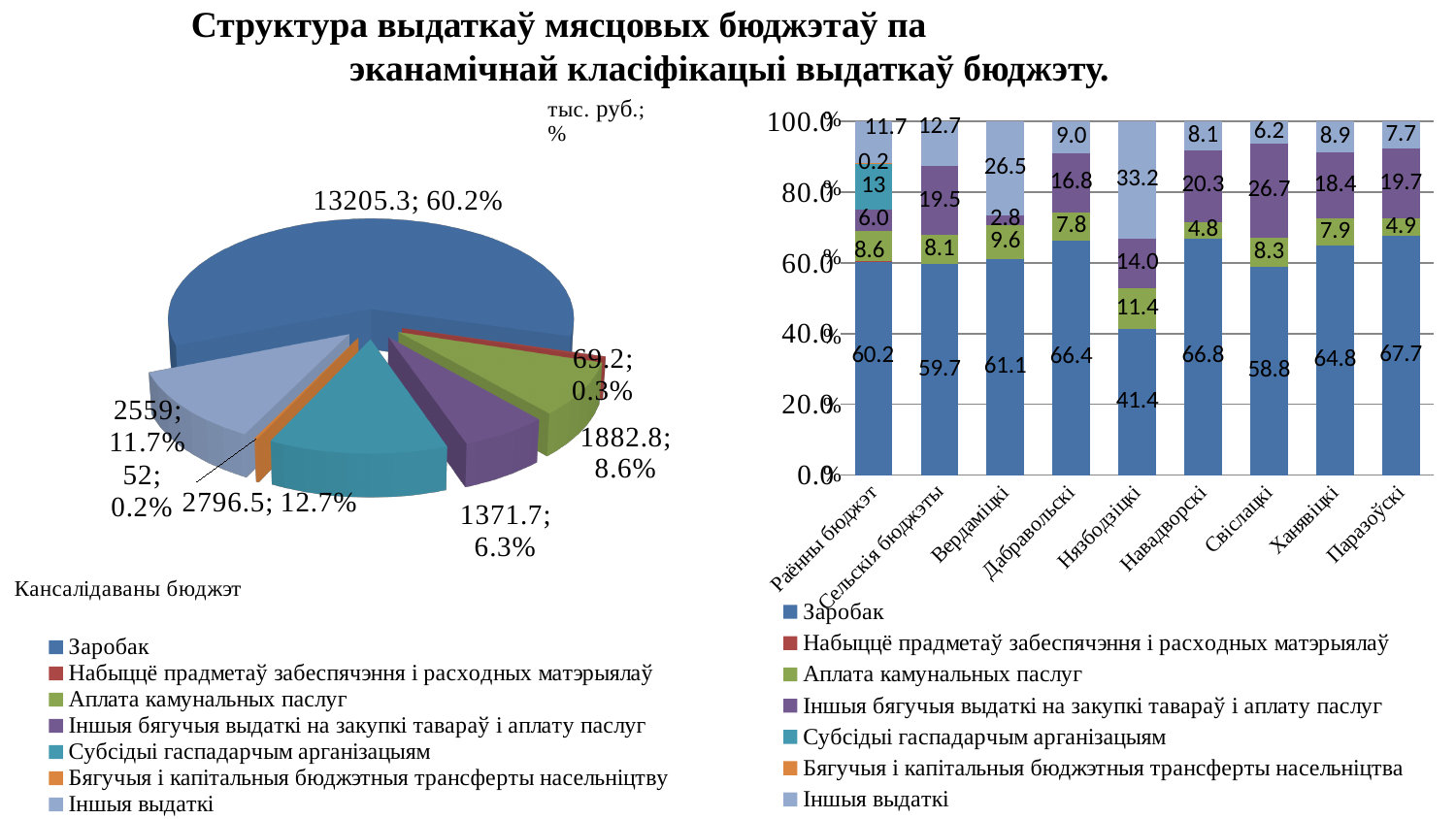
In the left pie chart, what value and share are shown for Заробак? 13205.3; 60.2% What type of chart is the right chart? stacked bar chart In the right bar chart, what is the Заробак value for Нязбодзіцкі? 41.4 What type of chart is the left chart (Кансалідаваны бюджэт)? pie chart In the left pie chart, what share does Субсідыі гаспадарчым арганізацыям have? 12.7% In the left pie chart, which category has the smallest slice? Бягучыя і капітальныя бюджэтныя трансферты насельніцтву In the right bar chart, which category has the highest Заробак value? Паразоўскі In the right bar chart, which category has the lowest Заробак value? Нязбодзіцкі In the right bar chart, how many series does the legend list? 7 In the left pie chart, how many categories does the legend list? 7 In the right bar chart, what is the difference between the Іншыя выдаткі values for Нязбодзіцкі and Вердаміцкі? 6.7 In the right bar chart, how many categories are shown on the x axis? 9